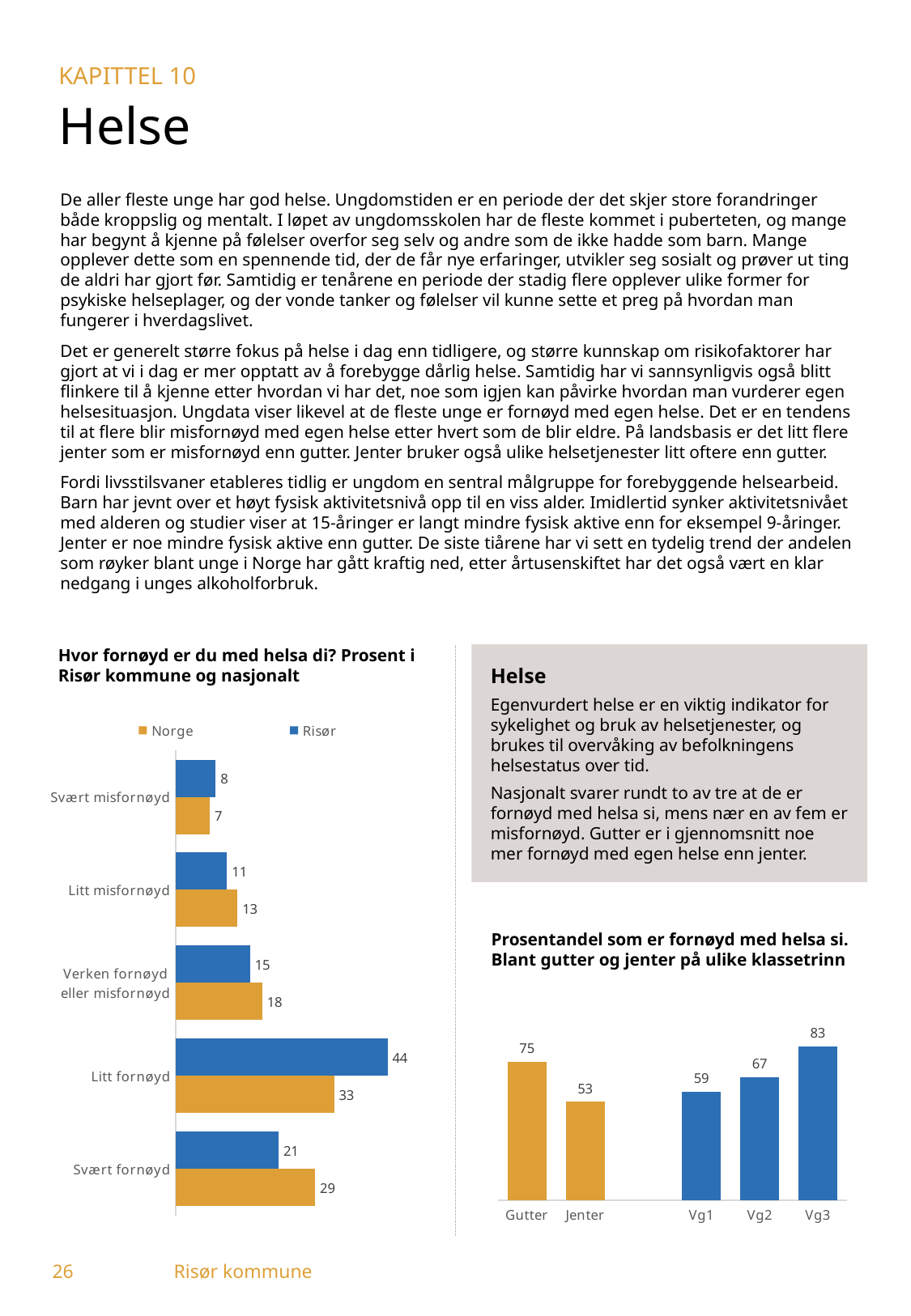
In the chart 'Hvor fornøyd er du med helsa di?', what is the difference between Risør and Norge for 'Litt fornøyd'? 11 In the chart 'Hvor fornøyd er du med helsa di?', what is the value for Risør in the category 'Litt fornøyd'? 44 In the chart 'Hvor fornøyd er du med helsa di?', which category has the lowest value for Norge? Svært misfornøyd In the chart 'Hvor fornøyd er du med helsa di?', what is the value for Norge in the category 'Svært fornøyd'? 29 How many categories are shown in the chart 'Hvor fornøyd er du med helsa di?'? 5 In the chart 'Prosentandel som er fornøyd med helsa si', what is the difference between Gutter and Jenter? 22 In the chart 'Prosentandel som er fornøyd med helsa si', which category has the highest value? Vg3 In the chart 'Hvor fornøyd er du med helsa di?', which is larger for 'Verken fornøyd eller misfornøyd': Norge or Risør? Norge In the chart 'Prosentandel som er fornøyd med helsa si', do the values rise or fall from Vg1 to Vg3? rise In the chart 'Hvor fornøyd er du med helsa di?', which category has the highest value for Risør? Litt fornøyd In the chart 'Prosentandel som er fornøyd med helsa si', what is the value for Jenter? 53 How many series does the legend of the chart 'Hvor fornøyd er du med helsa di?' list? 2